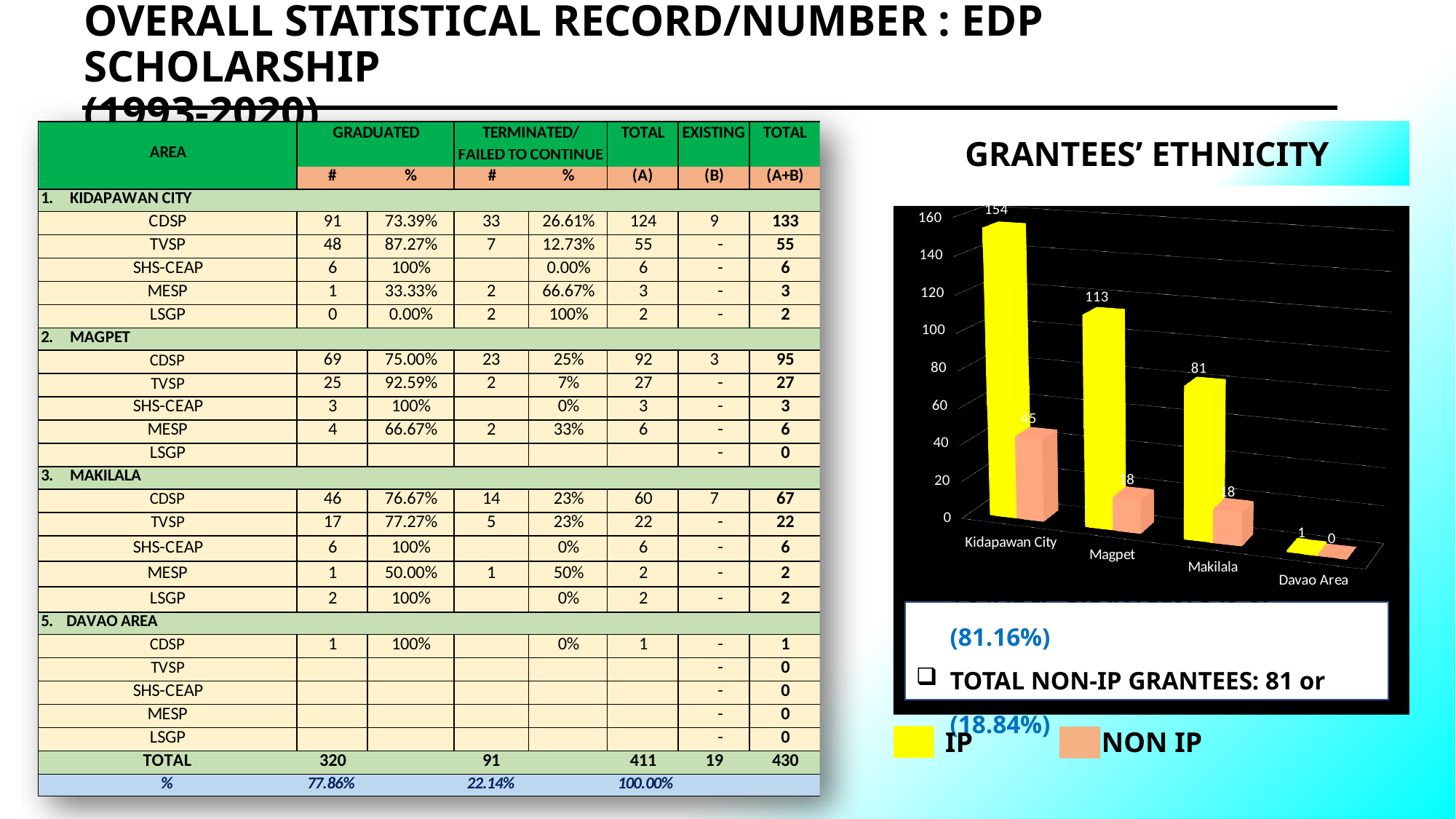
In the GRANTEES' ETHNICITY chart, what is the IP value for Kidapawan City? 154 In the GRANTEES' ETHNICITY chart, what is the NON IP value for Kidapawan City? 45 In the GRANTEES' ETHNICITY chart, which area has the lowest IP value? Davao Area What kind of chart is the GRANTEES' ETHNICITY chart? bar chart In the GRANTEES' ETHNICITY chart, which colour represents the IP series? yellow In the GRANTEES' ETHNICITY chart, what is the difference between the IP values for Kidapawan City and Magpet? 41 How many areas are shown on the x axis of the GRANTEES' ETHNICITY chart? 4 In the GRANTEES' ETHNICITY chart, what is the IP value for Magpet? 113 How many series does the legend of the GRANTEES' ETHNICITY chart list? 2 In the GRANTEES' ETHNICITY chart, which area has the highest IP value? Kidapawan City In the GRANTEES' ETHNICITY chart, do the IP values rise or fall from Kidapawan City to Davao Area? fall In the GRANTEES' ETHNICITY chart, what is the IP value for Makilala? 81